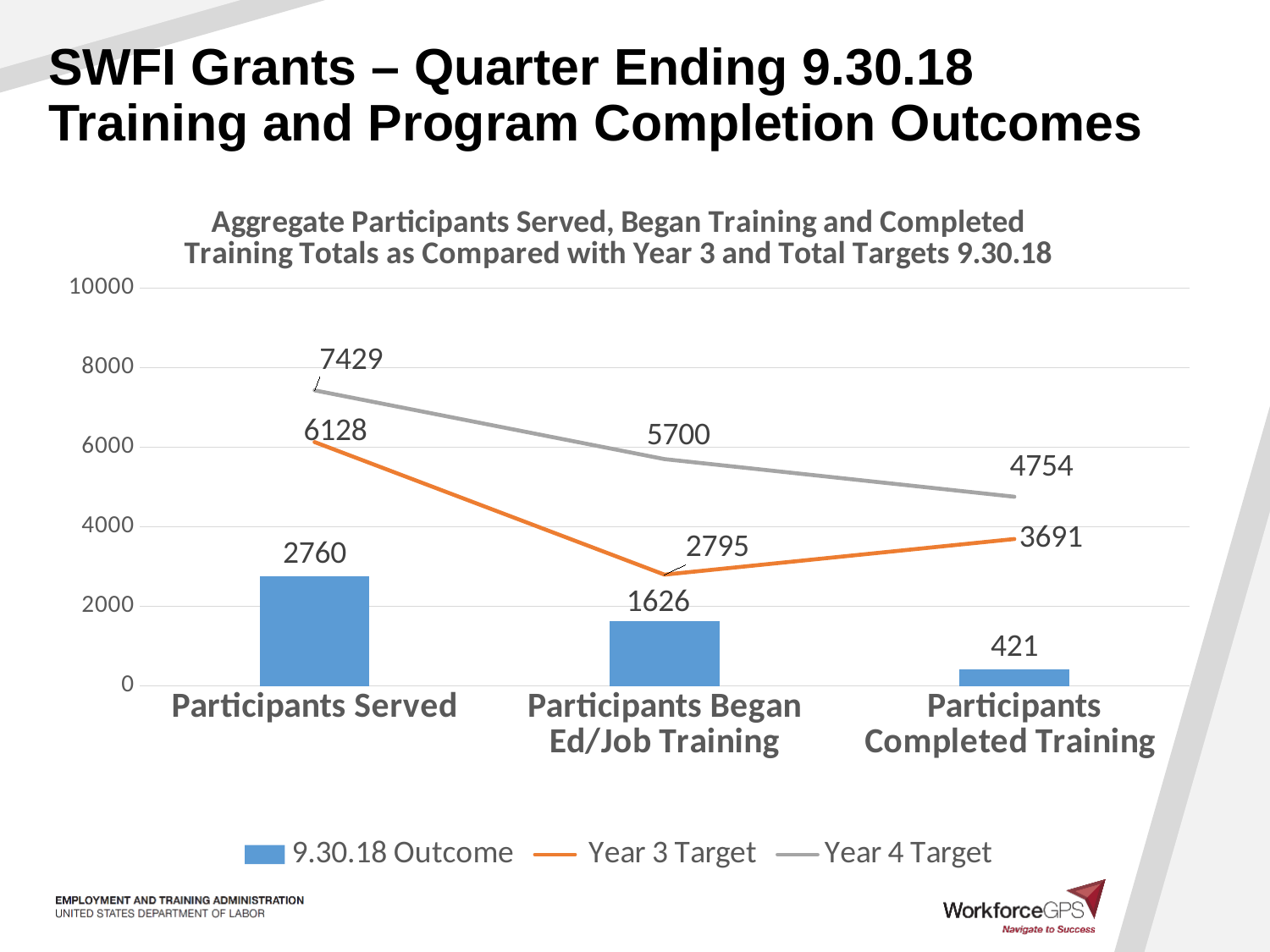
Which series is shown as bars rather than lines? 9.30.18 Outcome Does the Year 4 Target rise or fall from Participants Served to Participants Completed Training? fall What is the 9.30.18 Outcome value for Participants Completed Training? 421 How many categories are shown on the x axis? 3 What is the Year 4 Target for Participants Completed Training? 4754 What is the Year 3 Target for Participants Began Ed/Job Training? 2795 Which category has the lowest 9.30.18 Outcome? Participants Completed Training What is the 9.30.18 Outcome value for Participants Served? 2760 How many series does the legend list? 3 What is the difference between the Year 4 Target and the Year 3 Target for Participants Served? 1301 Which is larger for Participants Completed Training: the Year 3 Target or the 9.30.18 Outcome? Year 3 Target Which category has the highest Year 4 Target? Participants Served